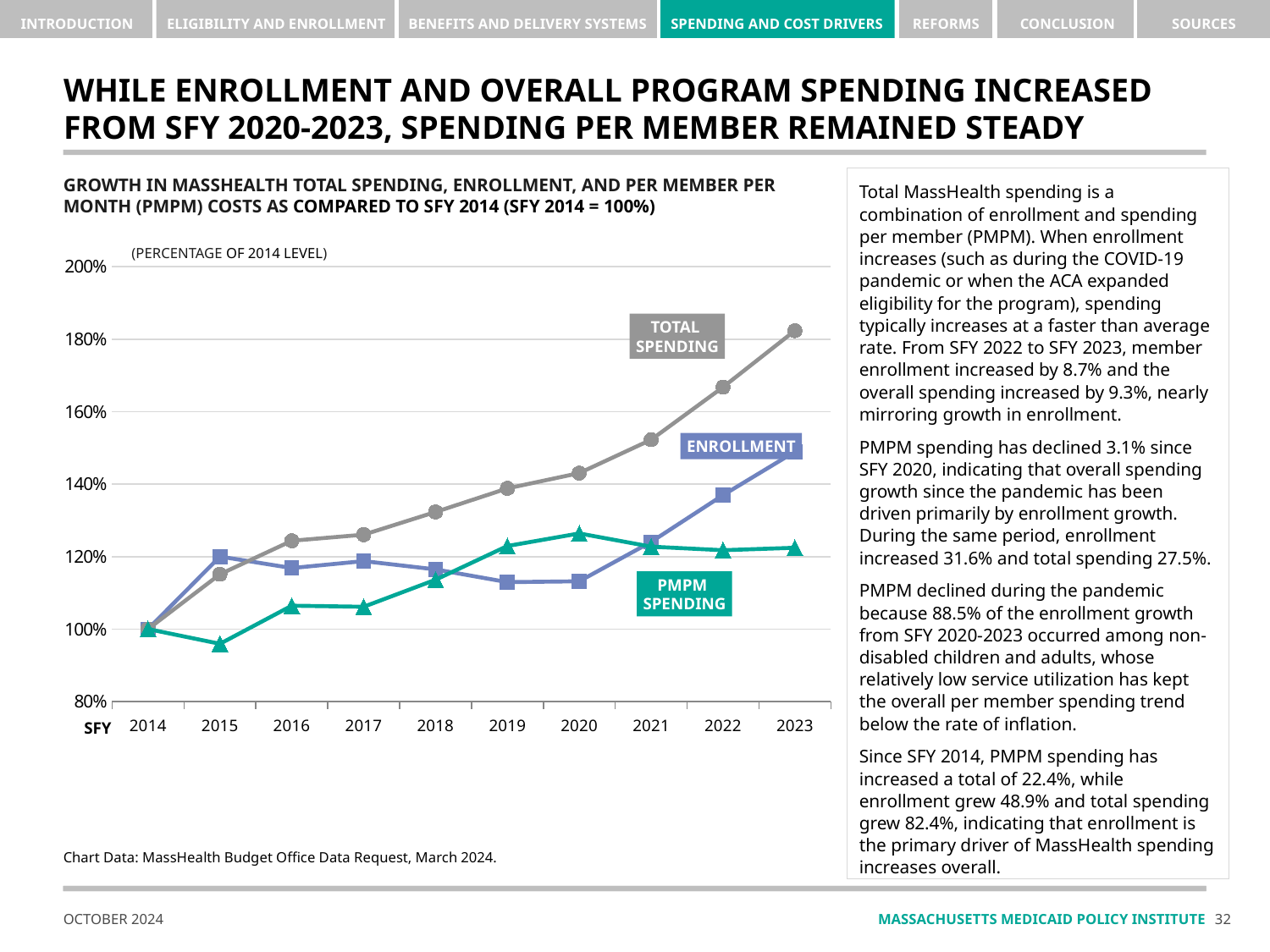
Which series has the lowest value in SFY 2023? PMPM Spending What type of chart is shown on the slide? Line chart What is the value of Total Spending in SFY 2014? 100% Is the value for Enrollment in SFY 2023 greater or less than 160%? less Does Total Spending rise or fall from SFY 2014 to SFY 2023? Rise How many fiscal years are shown along the x axis of the chart? 10 Is the value for PMPM Spending in SFY 2015 greater or less than 100%? less What is the title of the chart? Growth in MassHealth Total Spending, Enrollment, and Per Member Per Month (PMPM) Costs as Compared to SFY 2014 (SFY 2014 = 100%) How many series are plotted on the chart? 3 Which series has the highest value in SFY 2023? Total Spending Is the value for Total Spending in SFY 2023 greater or less than 180%? greater In SFY 2019, which is larger: Enrollment or PMPM Spending? PMPM Spending